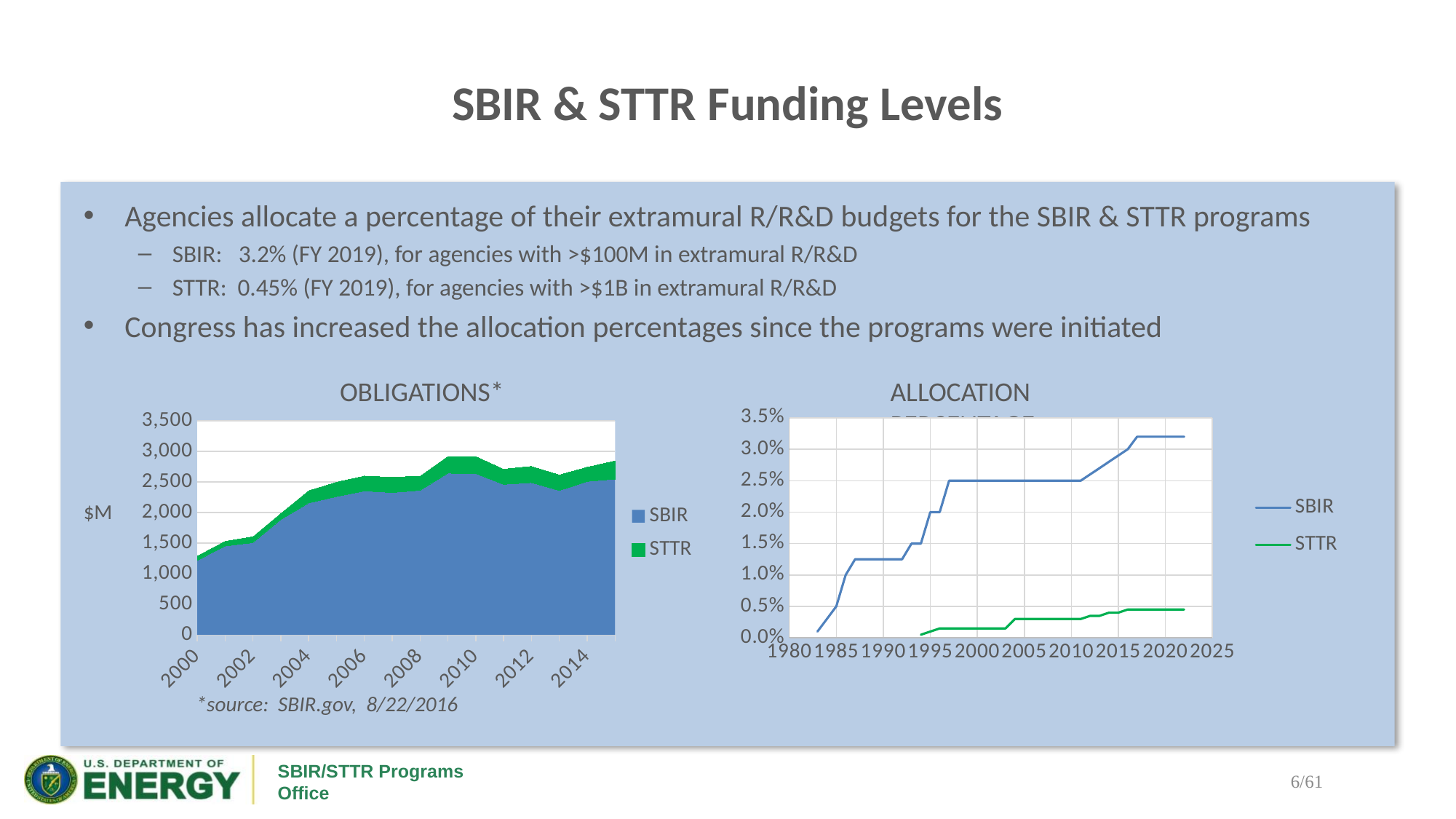
In the ALLOCATION PERCENTAGE chart, what is the SBIR allocation percentage in 2005? 2.5% In the OBLIGATIONS* chart, is the SBIR value for 2000 greater or less than 1,500? less In the ALLOCATION PERCENTAGE chart, does the SBIR allocation percentage rise or fall from 1985 to 2020? rise In the ALLOCATION PERCENTAGE chart, is the SBIR value for 2020 greater or less than 3.0%? greater In the ALLOCATION PERCENTAGE chart, is the STTR value for 2020 greater or less than 1.0%? less In the OBLIGATIONS* chart, which series is shown in green? STTR In the OBLIGATIONS* chart, which series is larger in 2014, SBIR or STTR? SBIR What kind of chart is the ALLOCATION PERCENTAGE chart on the right? line chart What kind of chart is the OBLIGATIONS* chart on the left? area chart How many series does the legend of the OBLIGATIONS* chart list? 2 In the OBLIGATIONS* chart, do the SBIR obligations rise or fall from 2000 to 2010? rise